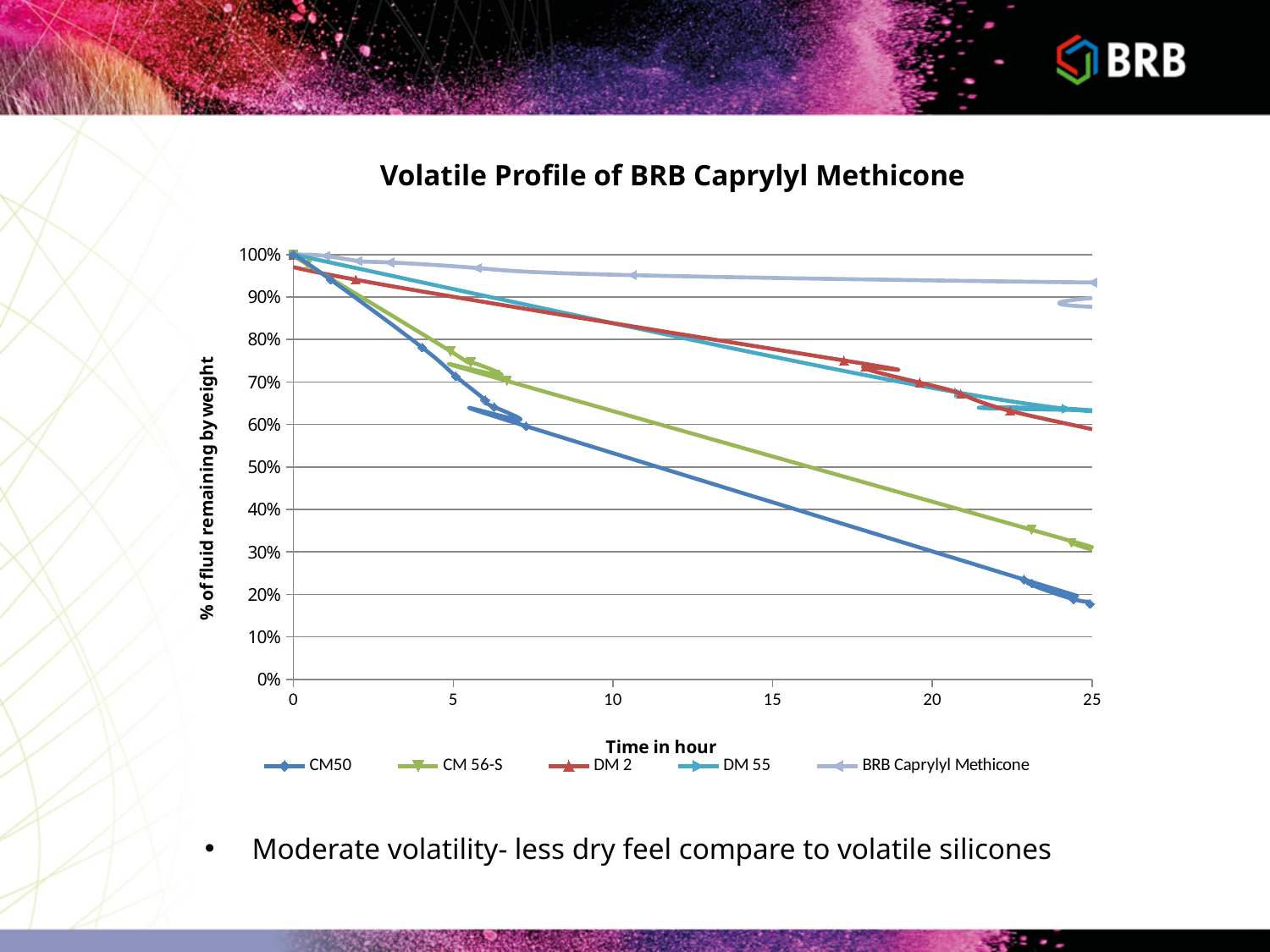
At 25 hours, which series has a higher % of fluid remaining, CM 56-S or CM50? CM 56-S What kind of chart is shown on the slide? line chart Which series has the highest % of fluid remaining at 25 hours? BRB Caprylyl Methicone What is the title of the chart? Volatile Profile of BRB Caprylyl Methicone Which series has the lowest % of fluid remaining at 25 hours? CM50 How many series does the legend list? 5 Is the value for CM 56-S at 25 hours greater or less than 40%? less Is the value for DM 2 at 25 hours greater or less than 70%? less Does the % of fluid remaining for CM50 rise or fall as time increases? fall At 10 hours, which series has a higher % of fluid remaining, DM 2 or CM 56-S? DM 2 Is the value for BRB Caprylyl Methicone at 25 hours greater or less than 90%? greater What is the label of the vertical axis? % of fluid remaining by weight